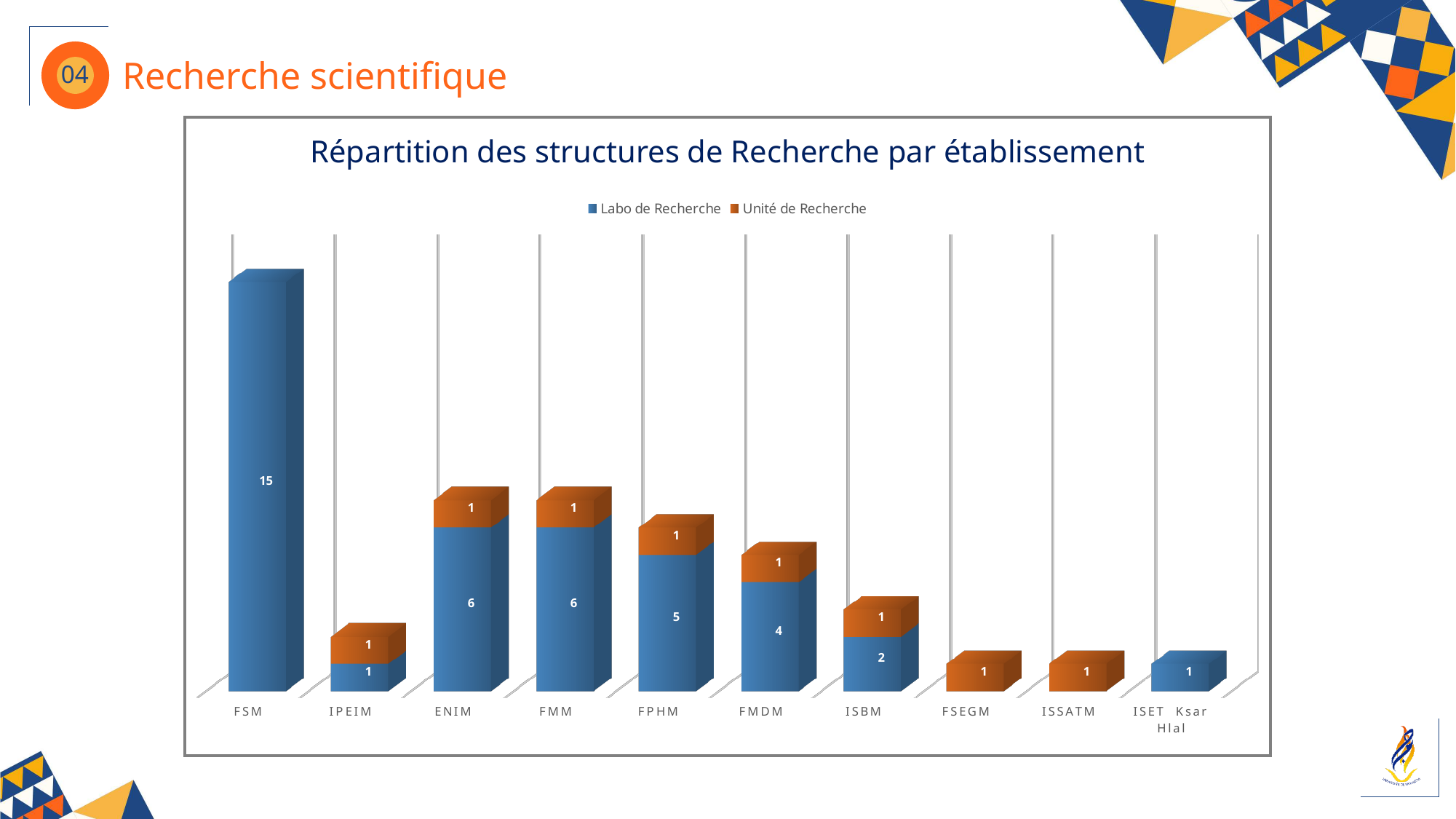
How many establishments are shown on the x axis? 10 What is the title of the chart? Répartition des structures de Recherche par établissement How many series does the legend list? 2 Which has a larger Labo de Recherche value, FMDM or ISBM? FMDM What kind of chart is shown on the slide? Stacked bar chart What is the difference between the Labo de Recherche values for FSM and ENIM? 9 What is the value of Labo de Recherche for FPHM? 5 What is the total of the stacked bar for ENIM? 7 What is the value of Labo de Recherche for FSM? 15 Which establishment has the highest Labo de Recherche value? FSM What is the total of the stacked bar for FPHM? 6 What is the value of Unité de Recherche for ISBM? 1